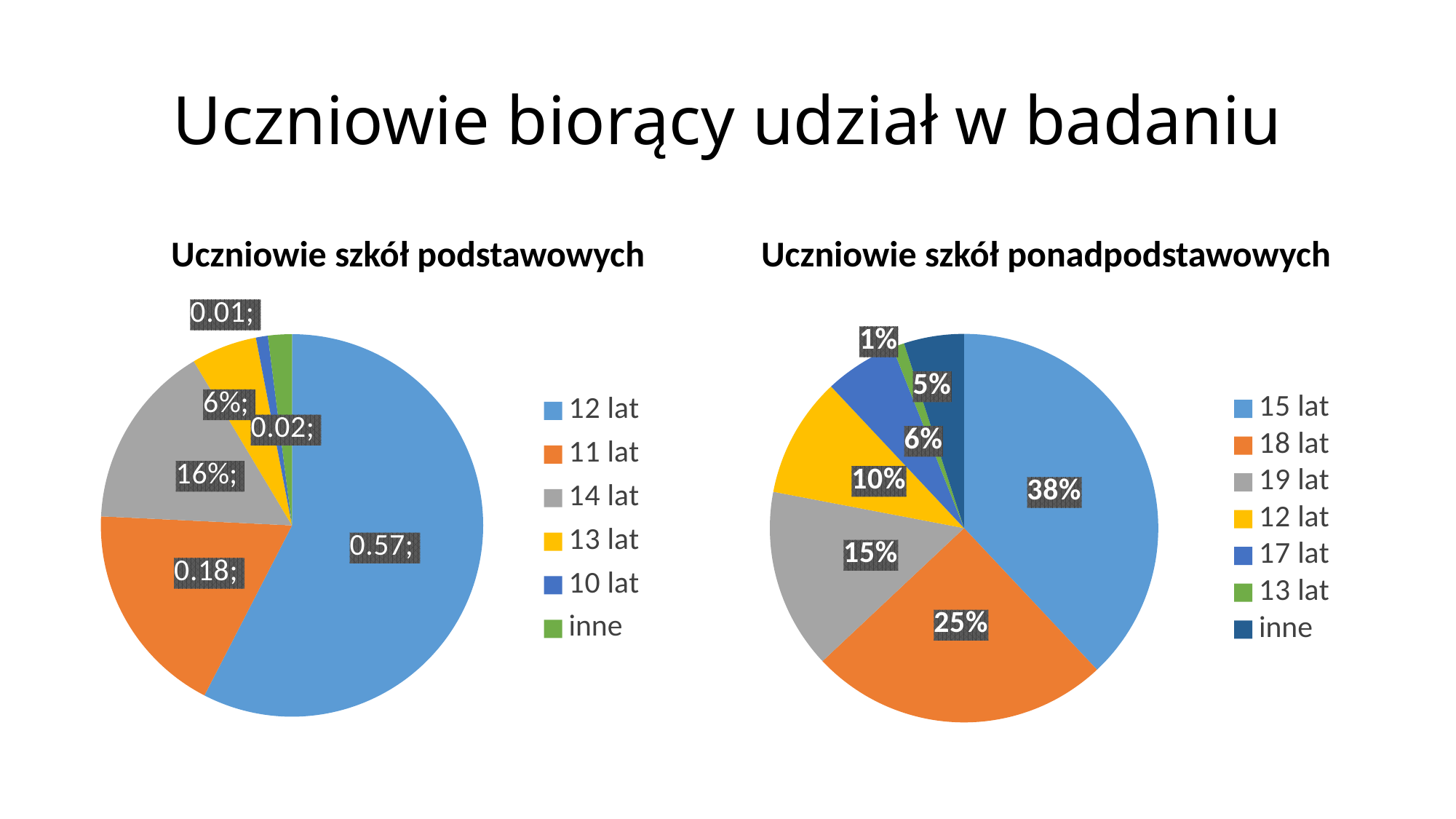
What type of chart is the chart titled 'Uczniowie szkół podstawowych'? pie chart In the chart titled 'Uczniowie szkół podstawowych', what is the value shown for 12 lat? 0.57; In the chart titled 'Uczniowie szkół ponadpodstawowych', what share of the pie is labelled for 15 lat? 38% In the chart titled 'Uczniowie szkół ponadpodstawowych', what is the difference between the values for 15 lat and 18 lat? 13% In the chart titled 'Uczniowie szkół ponadpodstawowych', which category has the smallest slice? 13 lat In the chart titled 'Uczniowie szkół ponadpodstawowych', how many categories does the legend list? 7 In the chart titled 'Uczniowie szkół ponadpodstawowych', which category has the largest slice? 15 lat In the chart titled 'Uczniowie szkół ponadpodstawowych', what is the value shown for 19 lat? 15% In the chart titled 'Uczniowie szkół ponadpodstawowych', which is larger: the slice for 12 lat or the slice for 17 lat? 12 lat In the chart titled 'Uczniowie szkół podstawowych', what is the value shown for 14 lat? 16%; In the chart titled 'Uczniowie szkół podstawowych', which category has the largest slice? 12 lat In the chart titled 'Uczniowie szkół ponadpodstawowych', what is the value shown for 18 lat? 25%